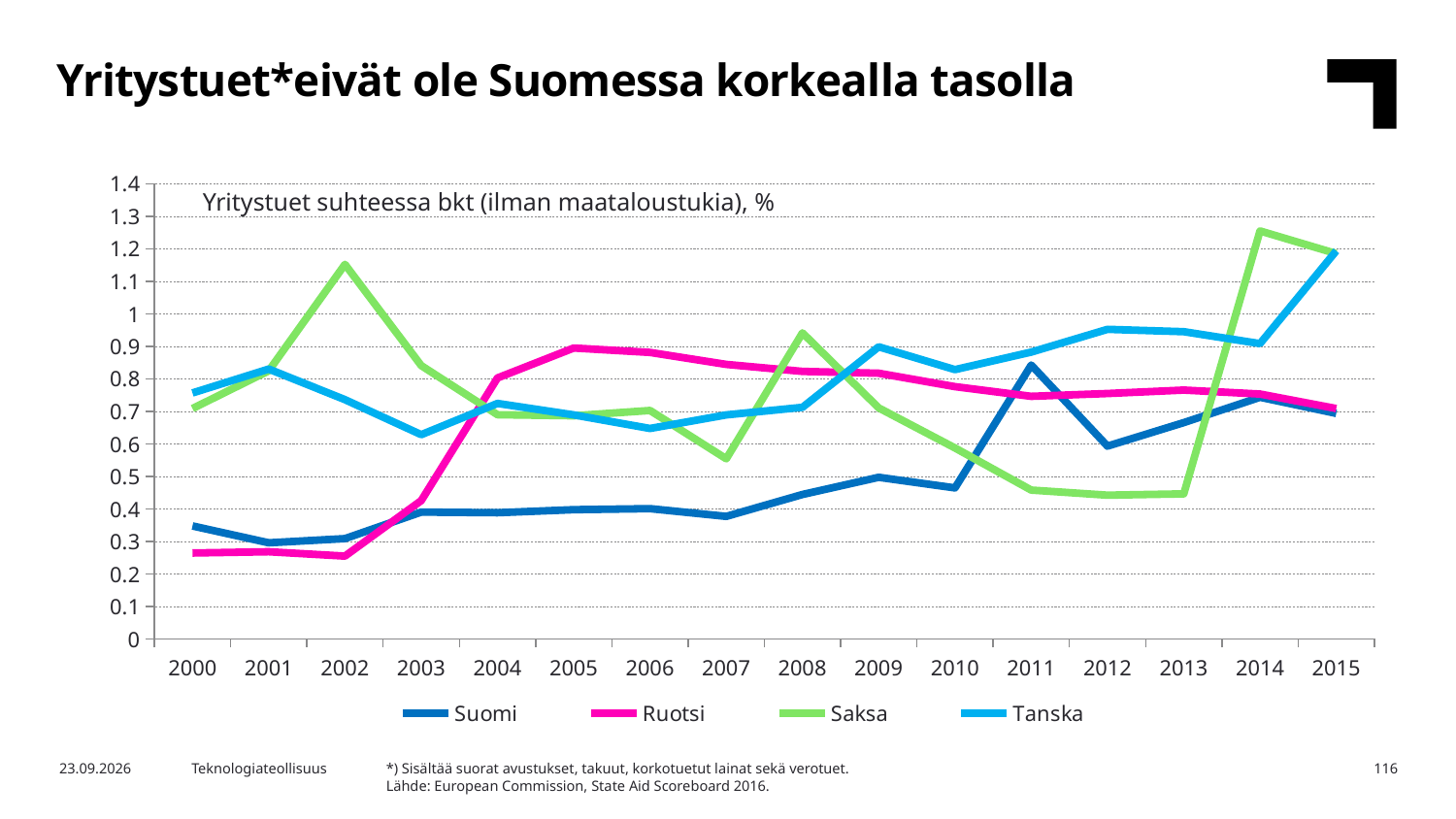
Which series has the lowest value in 2000? Ruotsi How many series does the legend list? 4 Is the value for Suomi in 2012 greater or less than 0.7? less Is the value for Tanska in 2015 greater or less than 1? greater Which countries are listed in the legend? Suomi, Ruotsi, Saksa, Tanska In 2005, which is larger, the value for Ruotsi or the value for Suomi? Ruotsi Which series has the highest value in 2014? Saksa Does the Suomi line overall rise or fall from 2000 to 2015? Rise What is the title printed inside the chart area? Yritystuet suhteessa bkt (ilman maataloustukia), % Is the value for Saksa in 2002 greater or less than 1? greater What kind of chart is shown on the slide? Line chart How many years are shown on the x axis? 16